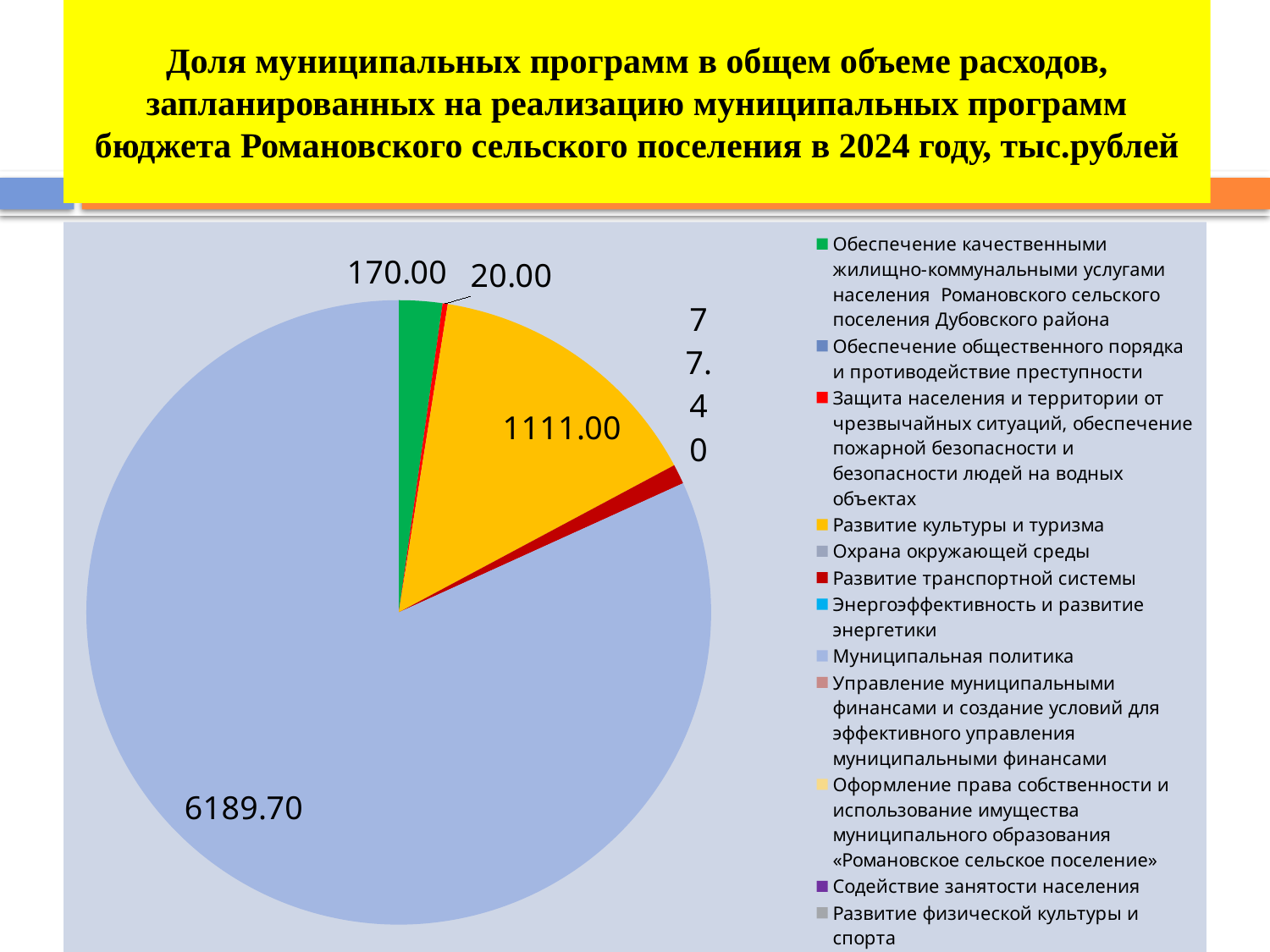
What is the value shown for «Защита населения и территории от чрезвычайных ситуаций...»? 20.00 What is the value shown for «Обеспечение качественными жилищно-коммунальными услугами населения...»? 170.00 How many entries does the legend list? 12 What colour is the slice for «Развитие культуры и туризма»? yellow What is the value of the largest slice in the pie chart? 6189.70 Which is larger: «Развитие культуры и туризма» or «Обеспечение качественными жилищно-коммунальными услугами»? Развитие культуры и туризма What is the difference between the values for «Обеспечение качественными жилищно-коммунальными услугами» and «Защита населения и территории от чрезвычайных ситуаций»? 150.00 What type of chart is shown on the slide? pie chart What is the value shown for «Развитие транспортной системы»? 77.40 What is the difference between the values for «Развитие культуры и туризма» and «Обеспечение качественными жилищно-коммунальными услугами»? 941.00 What is the value shown for «Развитие культуры и туризма»? 1111.00 Which labelled slice has the smallest value? Защита населения и территории от чрезвычайных ситуаций (20.00)